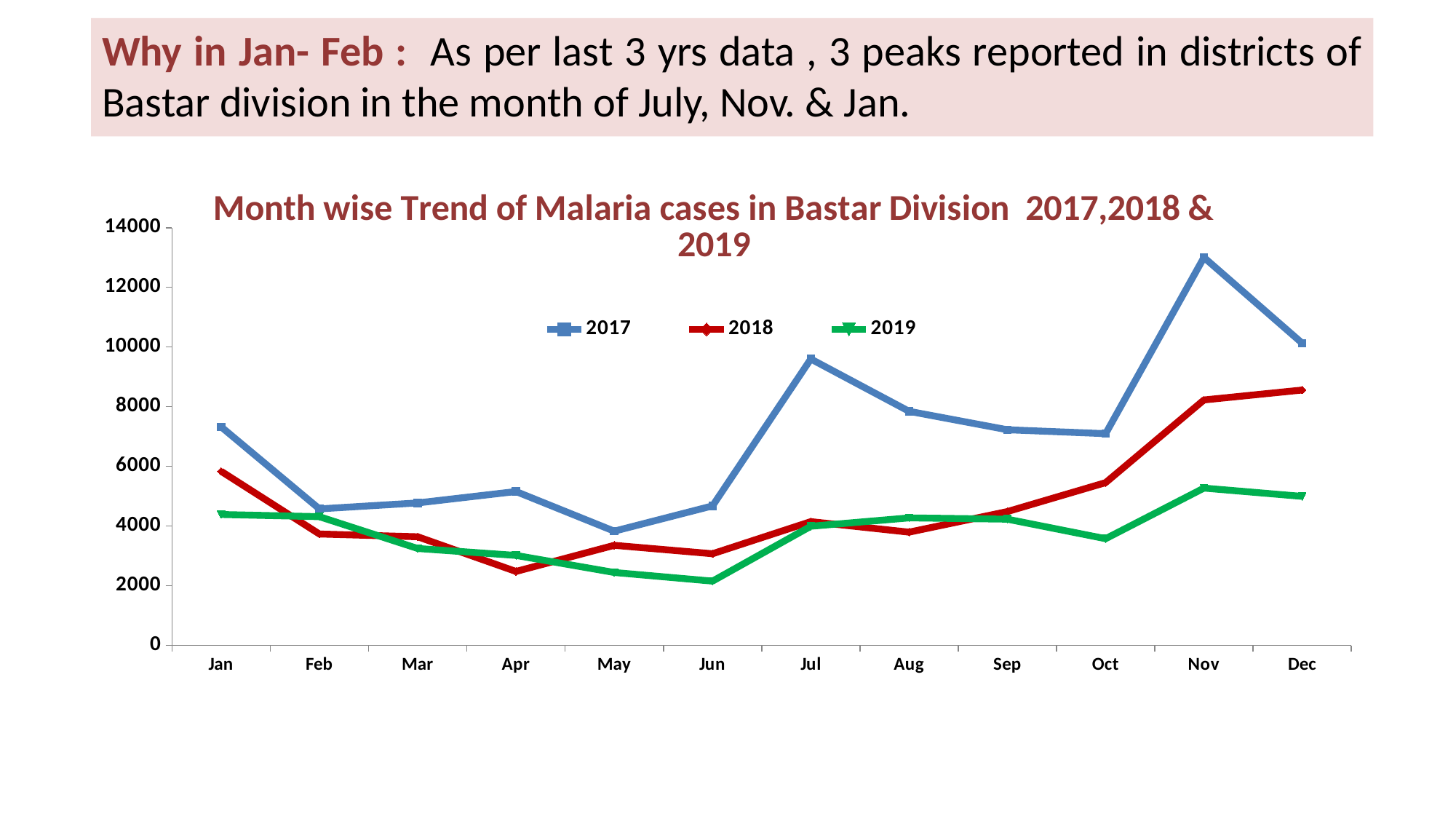
How many months are plotted along the x axis of the chart? 12 Which series has the larger value in Nov, 2017 or 2018? 2017 How many series does the legend list in the chart? 3 In which month does the 2019 series reach its lowest value? Jun Is the value for 2019 in Jun greater or less than 4000? less Is the value for 2017 in Jul greater or less than 8000? greater In which month does the 2018 series reach its lowest value? Apr In which month does the 2017 series reach its highest value? Nov Which series has the larger value in Jan, 2018 or 2019? 2018 Does the 2017 series rise or fall from Oct to Nov? rise What type of chart is shown on the slide? line chart Is the value for 2017 in Nov greater or less than 12000? greater